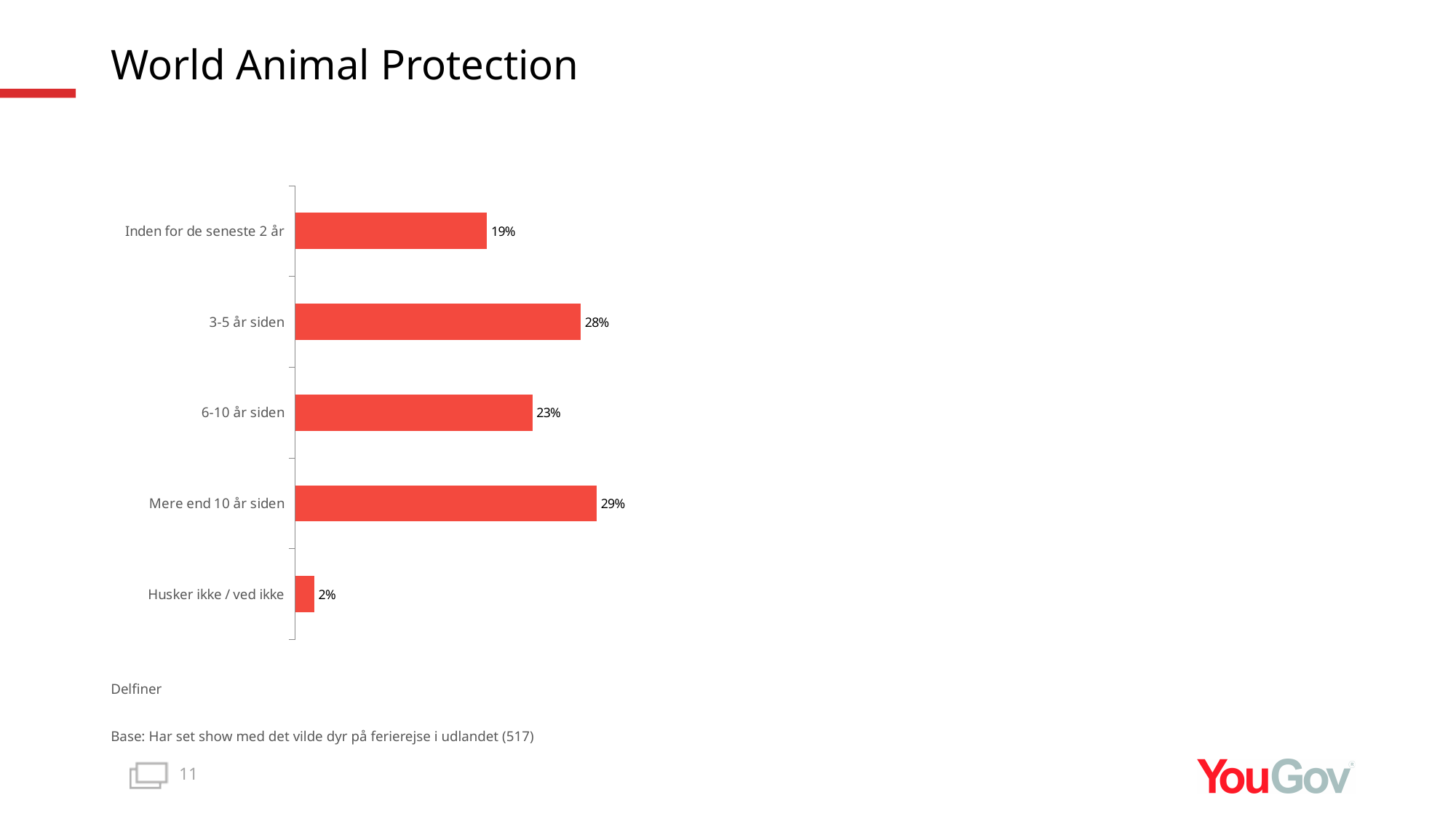
What is the value for "Inden for de seneste 2 år"? 19% Which category has the highest value? Mere end 10 år siden Which category has the lowest value? Husker ikke / ved ikke What is the difference between "Mere end 10 år siden" and "Inden for de seneste 2 år"? 10% What is the value for "3-5 år siden"? 28% What is the value for "Husker ikke / ved ikke"? 2% What is the base size stated below the chart? 517 What is the difference between "3-5 år siden" and "6-10 år siden"? 5% What kind of chart is shown on the slide? Bar chart Which is larger: "3-5 år siden" or "6-10 år siden"? 3-5 år siden What is the value for "6-10 år siden"? 23% How many categories are shown in the chart? 5